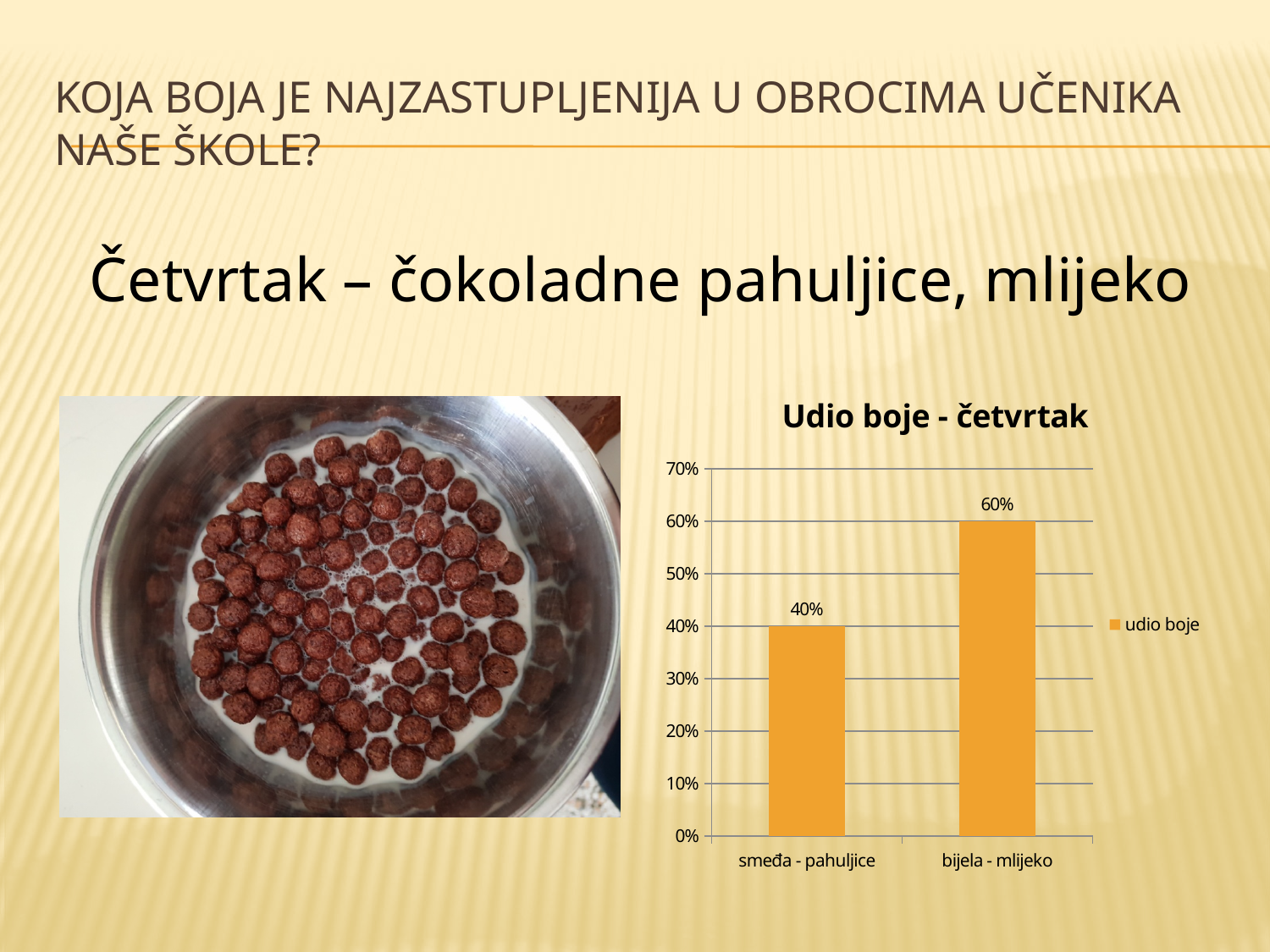
What kind of chart is shown? bar chart What is the difference between the values for bijela - mlijeko and smeđa - pahuljice? 20% How many series does the legend list? 1 How many categories are shown on the x axis? 2 What is the value for smeđa - pahuljice? 40% What is the title of the chart? Udio boje - četvrtak What is the value for bijela - mlijeko? 60% Is the value for bijela - mlijeko greater or less than 50%? greater Which category has the highest value? bijela - mlijeko Is the value for smeđa - pahuljice greater or less than 50%? less Which category has the lowest value? smeđa - pahuljice Which is larger, the value for smeđa - pahuljice or the value for bijela - mlijeko? bijela - mlijeko